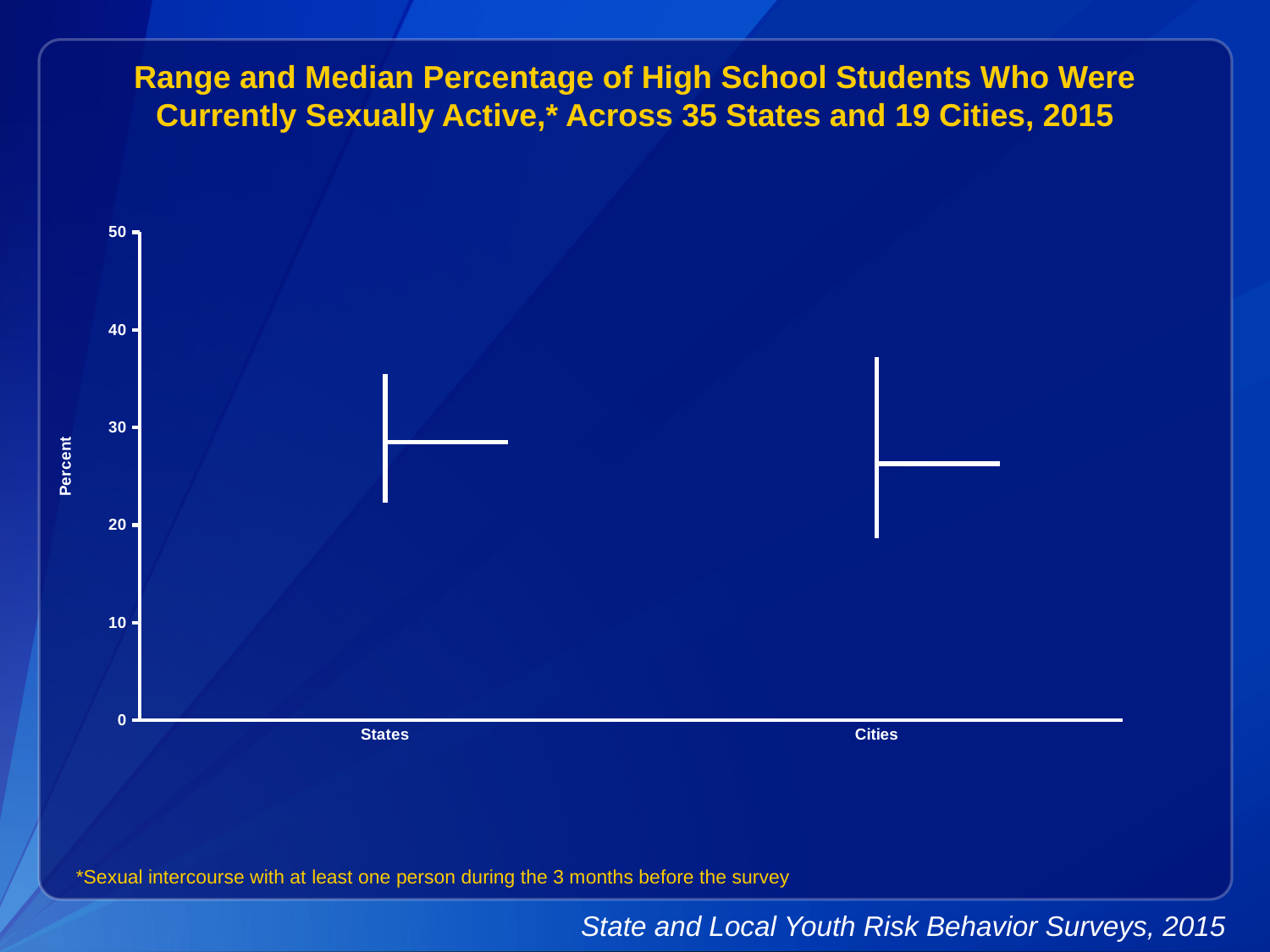
What are the two categories shown on the x axis? States and Cities Which category has the higher median value, States or Cities? States Is the top of the range for Cities greater or less than 30? greater Is the top of the range for States greater or less than 40? less Is the top of the range for Cities greater or less than 40? less What is the label of the y axis? Percent What is the maximum value shown on the y axis? 50 How many categories are shown on the x axis of the chart? 2 Which category has the higher top of its range, States or Cities? Cities